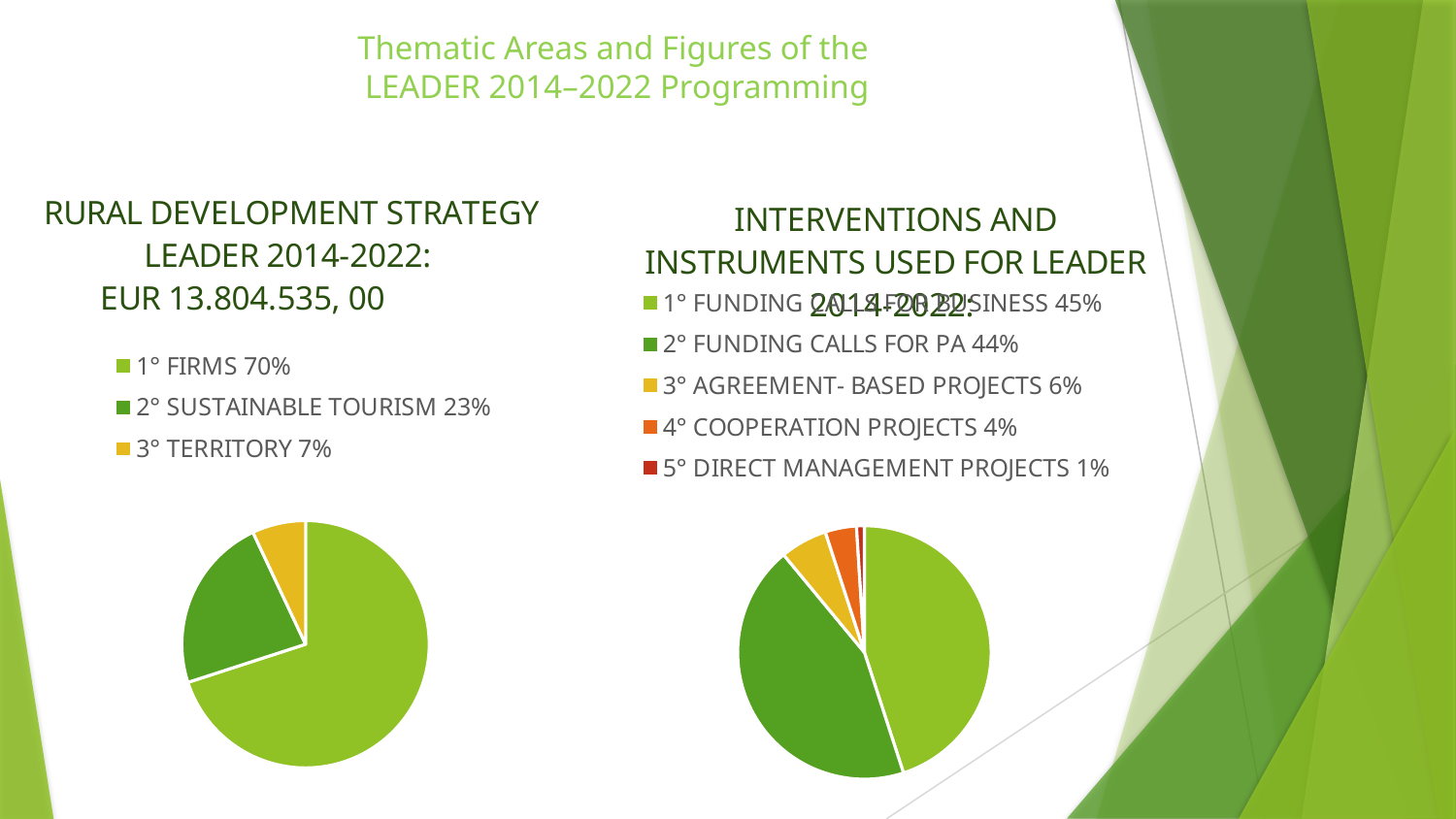
What type of chart is shown on the left of the slide under the Rural Development Strategy heading? pie chart What total amount in EUR is stated in the heading above the left pie chart? EUR 13.804.535, 00 In the left pie chart (Rural Development Strategy LEADER 2014-2022), what share is shown for 1° FIRMS? 70% In the left pie chart (Rural Development Strategy LEADER 2014-2022), what is the difference between the shares of 1° FIRMS and 2° SUSTAINABLE TOURISM? 47% In the left pie chart (Rural Development Strategy LEADER 2014-2022), which category has the smallest share? 3° TERRITORY In the right pie chart (Interventions and Instruments used for LEADER 2014-2022), what share is shown for 3° AGREEMENT-BASED PROJECTS? 6% In the right pie chart (Interventions and Instruments used for LEADER 2014-2022), what share is shown for 5° DIRECT MANAGEMENT PROJECTS? 1% In the left pie chart (Rural Development Strategy LEADER 2014-2022), what share is shown for 2° SUSTAINABLE TOURISM? 23% In the right pie chart (Interventions and Instruments used for LEADER 2014-2022), how many categories does the legend list? 5 In the left pie chart (Rural Development Strategy LEADER 2014-2022), how many categories does the legend list? 3 In the right pie chart (Interventions and Instruments used for LEADER 2014-2022), which is larger: the share for 3° AGREEMENT-BASED PROJECTS or 4° COOPERATION PROJECTS? 3° AGREEMENT-BASED PROJECTS In the right pie chart (Interventions and Instruments used for LEADER 2014-2022), which category has the smallest share? 5° DIRECT MANAGEMENT PROJECTS